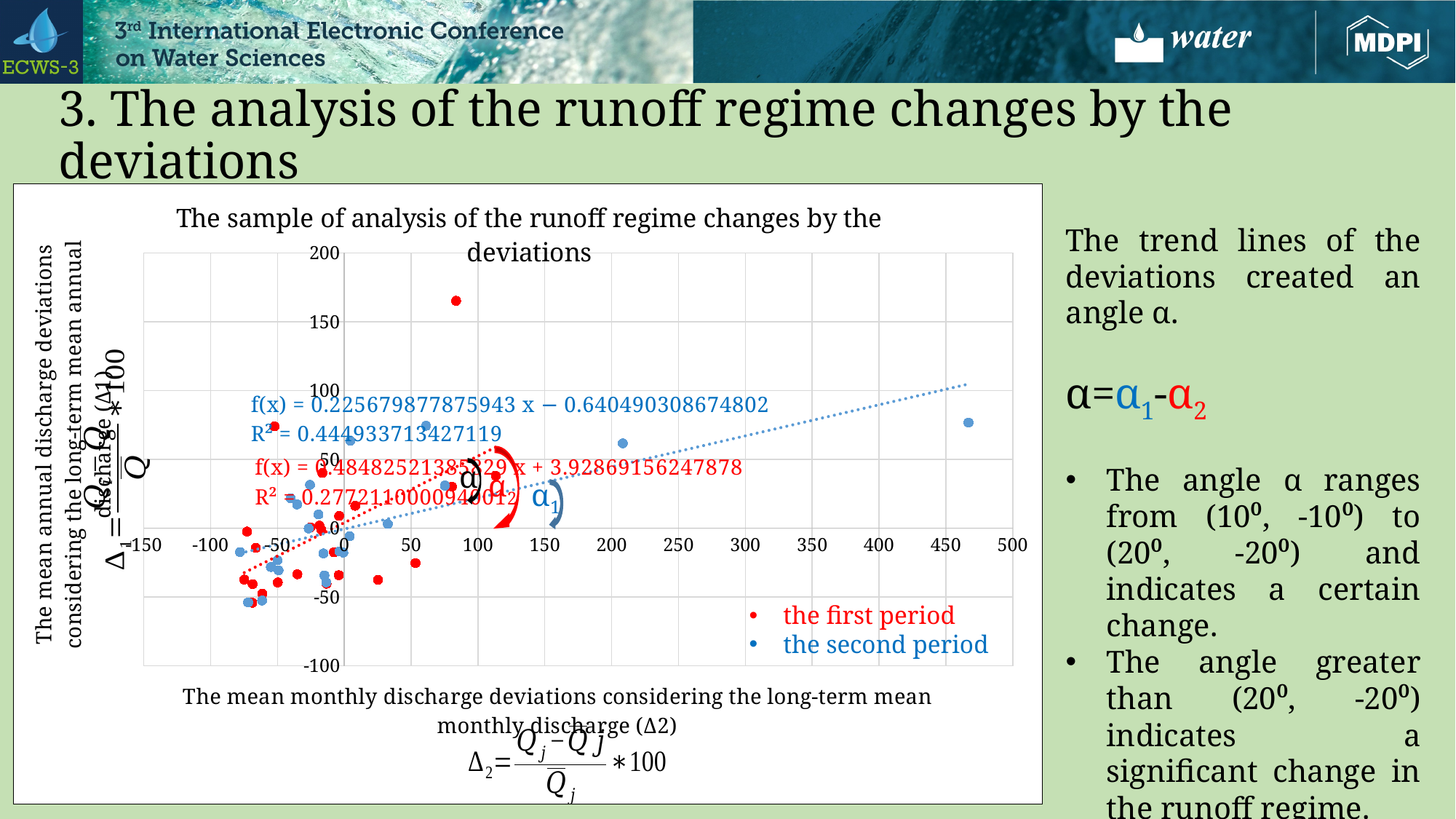
What is the title of the chart? The sample of analysis of the runoff regime changes by the deviations What is the slope coefficient in the printed trend-line equation for the second period (blue)? 0.225679877875943 How many series does the chart legend list? 2 What are the two series named in the chart legend? the first period; the second period What kind of chart is shown on the slide? scatter chart What R² value is printed for the red (first period) trend line? 0.277211000094012 Do the two dotted trend lines rise or fall as x increases? rise Is the y value of the highest red (first period) point greater or less than 150? greater Which period's trend line has the higher R² value? the second period Which period's trend line has the steeper slope? the first period What R² value is printed for the blue (second period) trend line? 0.444933713427119 What is the slope coefficient in the printed trend-line equation for the first period (red)? 0.484825213858329